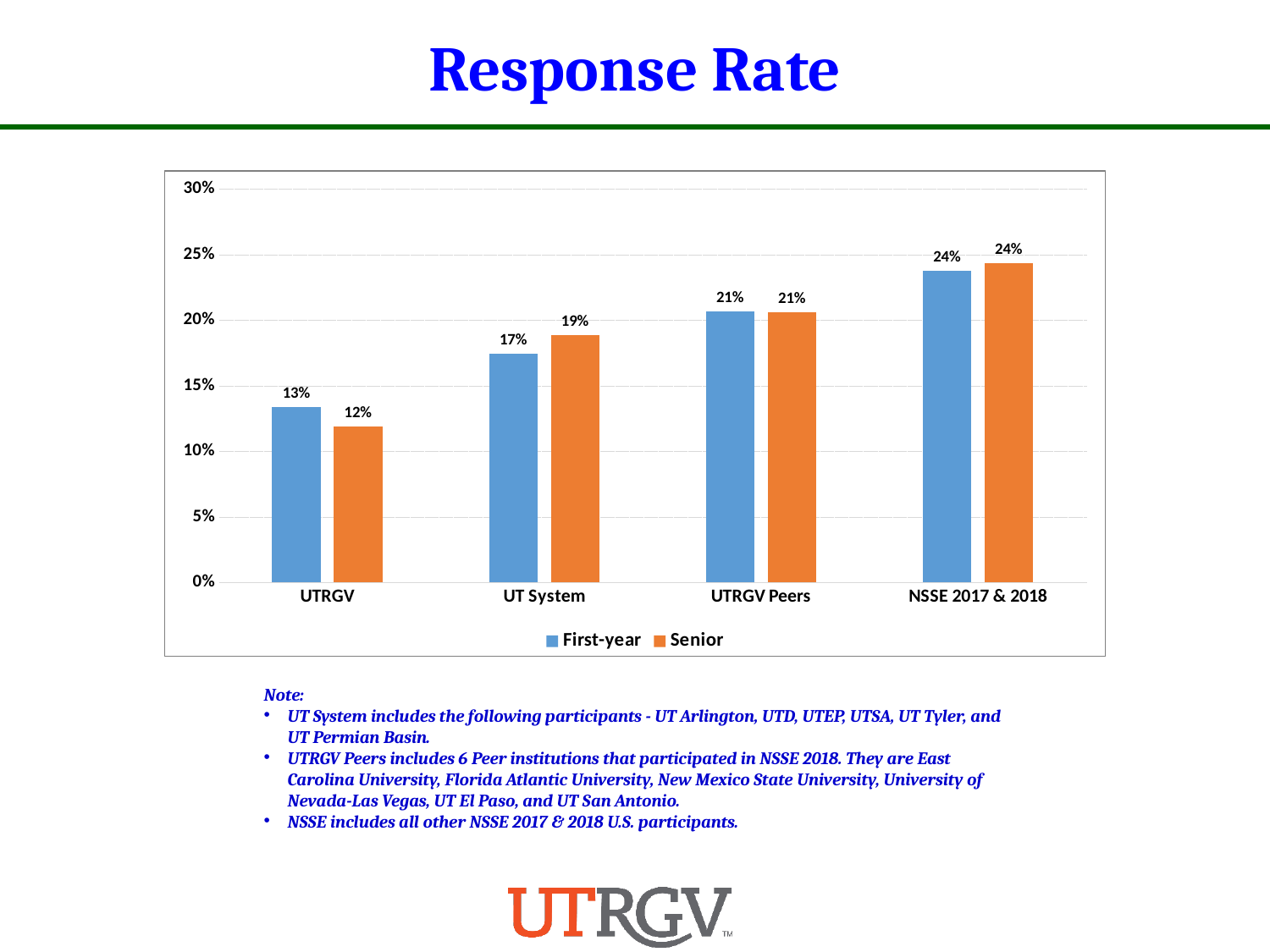
Which colour represents the Senior series in the chart? orange Which category has the lowest Senior response rate? UTRGV How many categories are shown on the x axis? 4 What is the difference between the Senior and First-year response rates for UT System? 2% Is the First-year response rate for UT System greater or less than 15%? greater Which category has the highest First-year response rate? NSSE 2017 & 2018 What kind of chart is shown on the slide? bar chart What is the Senior response rate for UTRGV Peers? 21% What is the Senior response rate for UT System? 19% How many series does the legend list? 2 What is the First-year response rate for UTRGV? 13% Is the First-year response rate for UTRGV higher or lower than the Senior response rate for UTRGV? higher